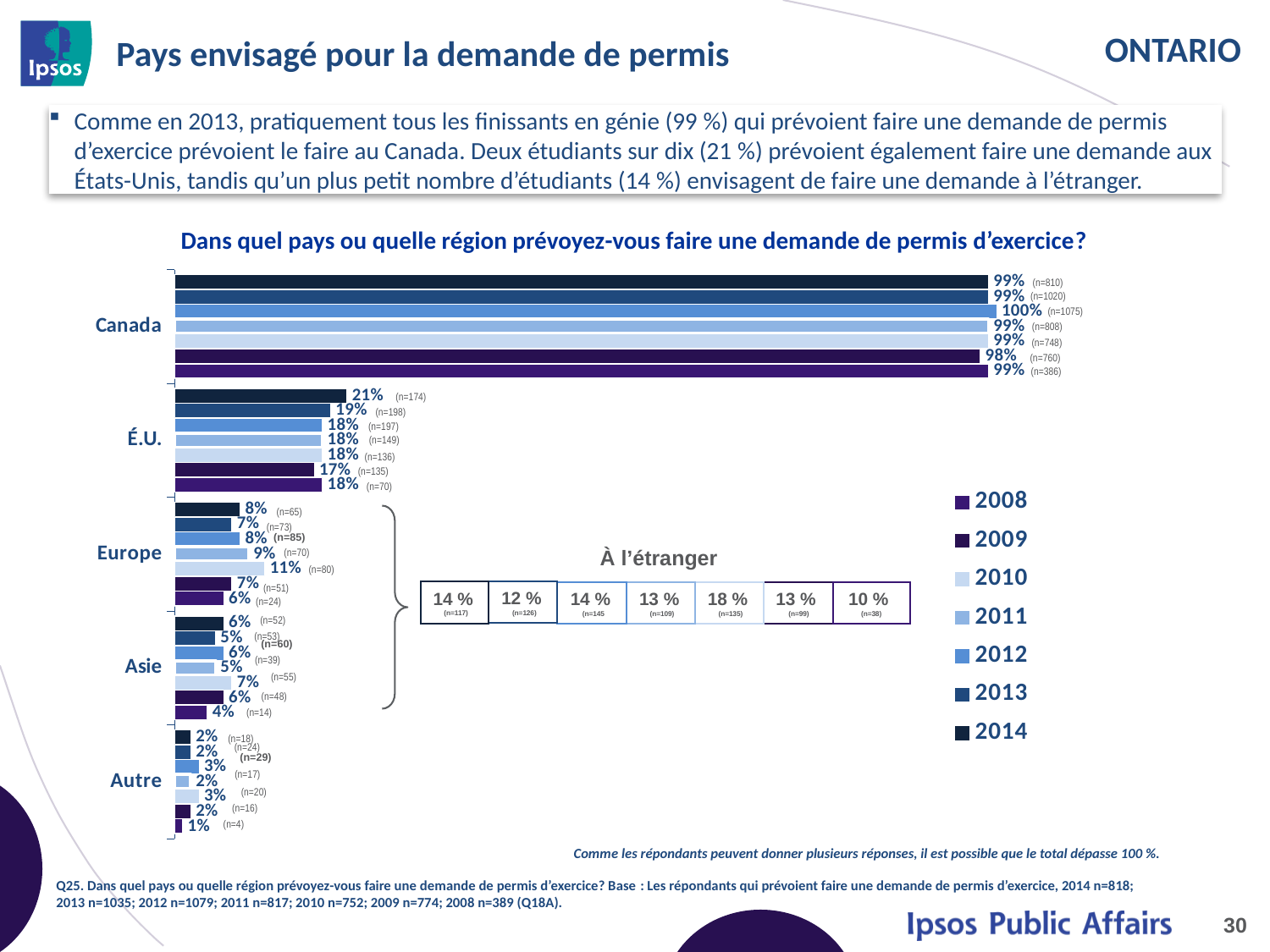
Which is larger: the 2014 value for Europe (n=65) or the 2014 value for Asie (n=52)? Europe What is the value for Canada in 2014 (the top bar, n=810)? 99% Which category has the highest values across all years? Canada What is the highest value shown in the 'À l'étranger' boxes? 18 % What kind of chart is shown on the slide? bar chart Which category has the lowest values across all years? Autre What is the value for Europe in 2010 (n=80)? 11% What is the value for Asie in 2008 (n=14)? 4% What is the difference between the 2014 value for É.U. (21%) and the 2014 value for Europe (8%)? 13 percentage points How many series does the legend list? 7 How many country/region categories are plotted on the chart? 5 What is the value for É.U. in 2014 (the top bar, n=174)? 21%